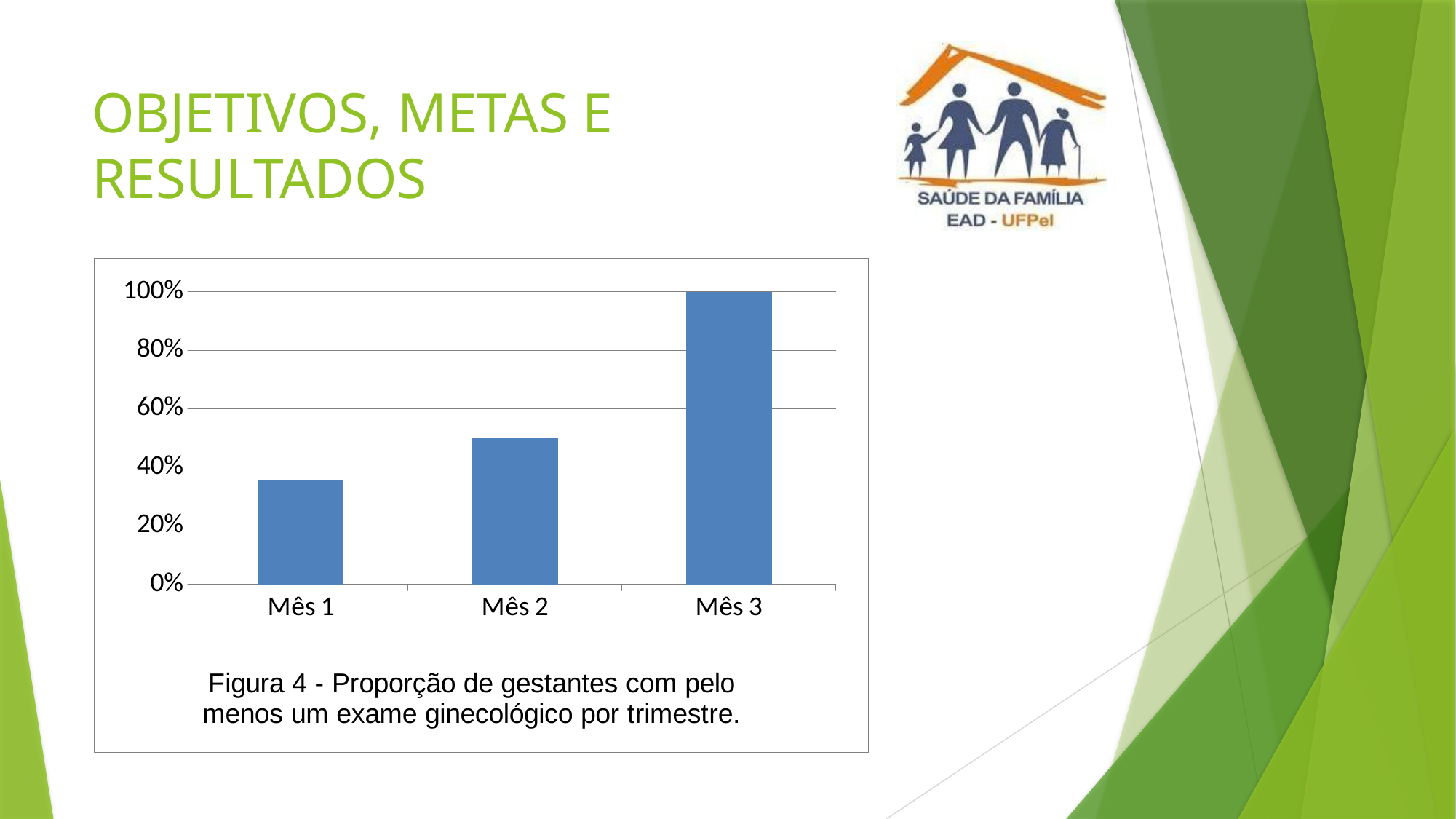
Is the value for Mês 2 greater or less than 60%? less Which month has the lowest value in the chart? Mês 1 Do the values rise or fall from Mês 1 to Mês 3? rise How many categories are plotted on the x axis of the chart? 3 What is the value for Mês 3? 100% Is the value for Mês 2 greater or less than 40%? greater Is the value for Mês 1 greater or less than 20%? greater Which month has the highest value in the chart? Mês 3 What kind of chart is shown on the slide? bar chart Which is larger, the value for Mês 1 or the value for Mês 2? Mês 2 What is the figure caption shown below the chart? Figura 4 - Proporção de gestantes com pelo menos um exame ginecológico por trimestre.